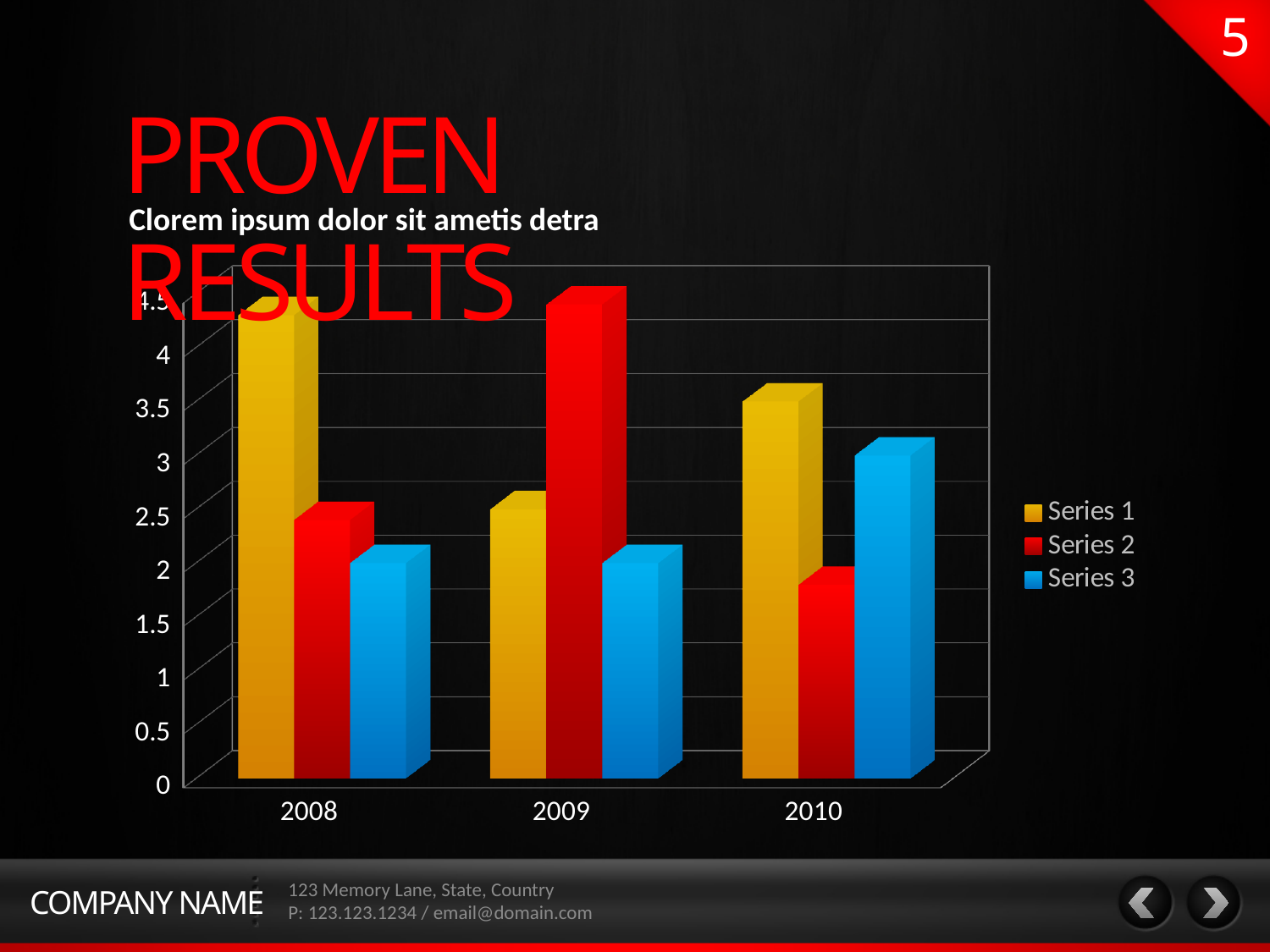
Which colour represents Series 2 in the legend? red In 2009, which is larger, Series 1 or Series 2? Series 2 Is the value for Series 2 in 2010 greater or less than 2? less How many series does the legend list? 3 In which year is Series 1 highest? 2008 Is the value for Series 1 in 2009 greater or less than 3? less How many categories are shown on the x axis? 3 In 2010, which is larger, Series 2 or Series 3? Series 3 In which year is Series 2 lowest? 2010 Is the value for Series 1 in 2008 greater or less than 4? greater What kind of chart is shown on the slide? bar chart In which year is Series 3 highest? 2010